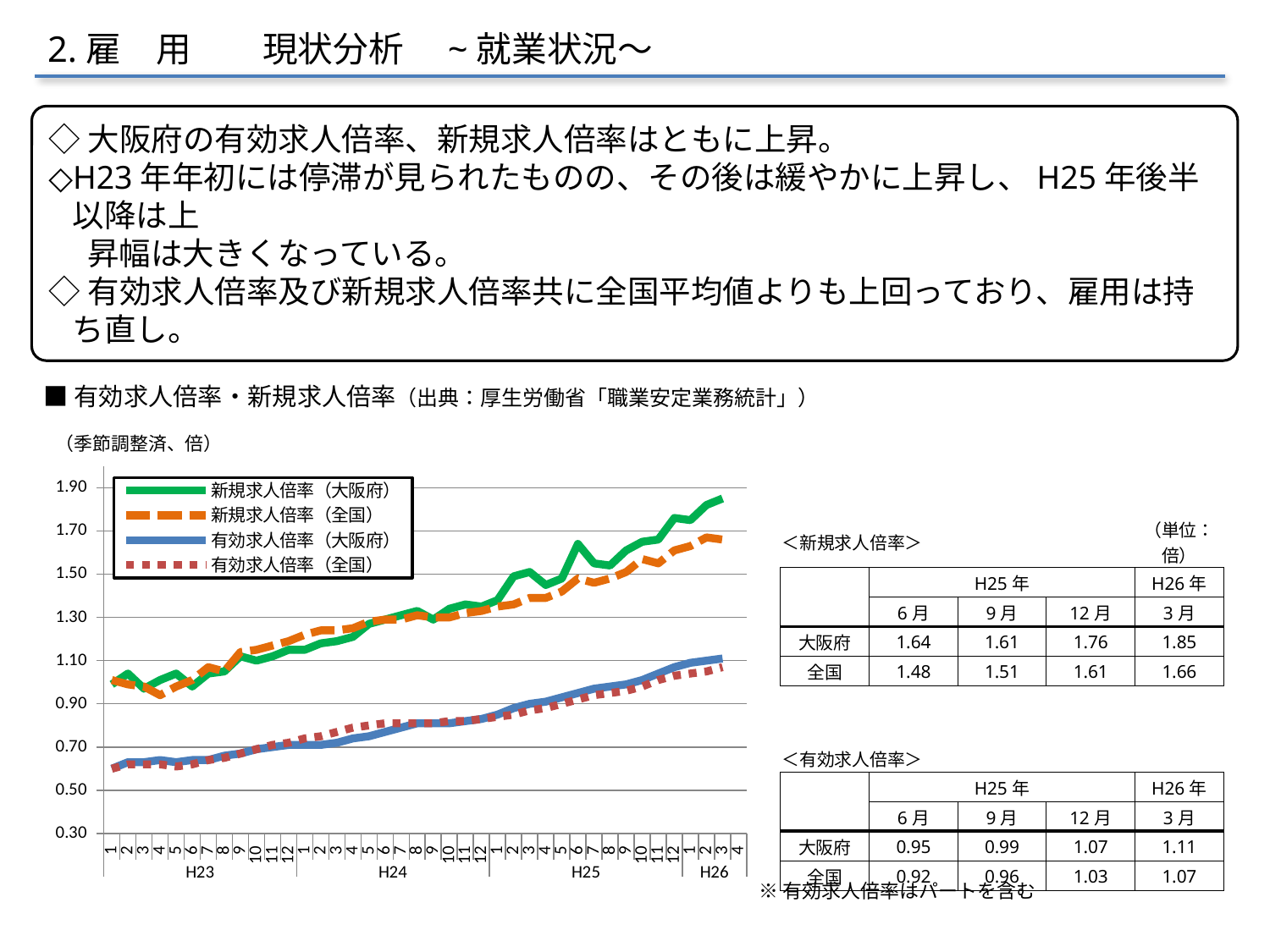
Which series has the highest value at the end of the chart (H26 3月)? 新規求人倍率（大阪府） Which series is drawn as a solid green line in the legend? 新規求人倍率（大阪府） Overall, do the values of 有効求人倍率（全国） rise or fall from H23 to H26? rise What is the highest value shown on the chart's vertical axis? 1.90 How many series does the chart legend list? 4 Is the value of 新規求人倍率（全国） at H23 1月 greater or less than 0.90? greater What kind of chart is shown on the slide? line chart Is the value of 有効求人倍率（全国） at H26 3月 greater or less than 0.90? greater Is the value of 有効求人倍率（大阪府） at H23 1月 greater or less than 0.70? less At H26 3月, which is larger: 新規求人倍率（大阪府） or 有効求人倍率（大阪府）? 新規求人倍率（大阪府） Overall, do the values of 新規求人倍率（大阪府） rise or fall from H23 to H26 along the x axis? rise